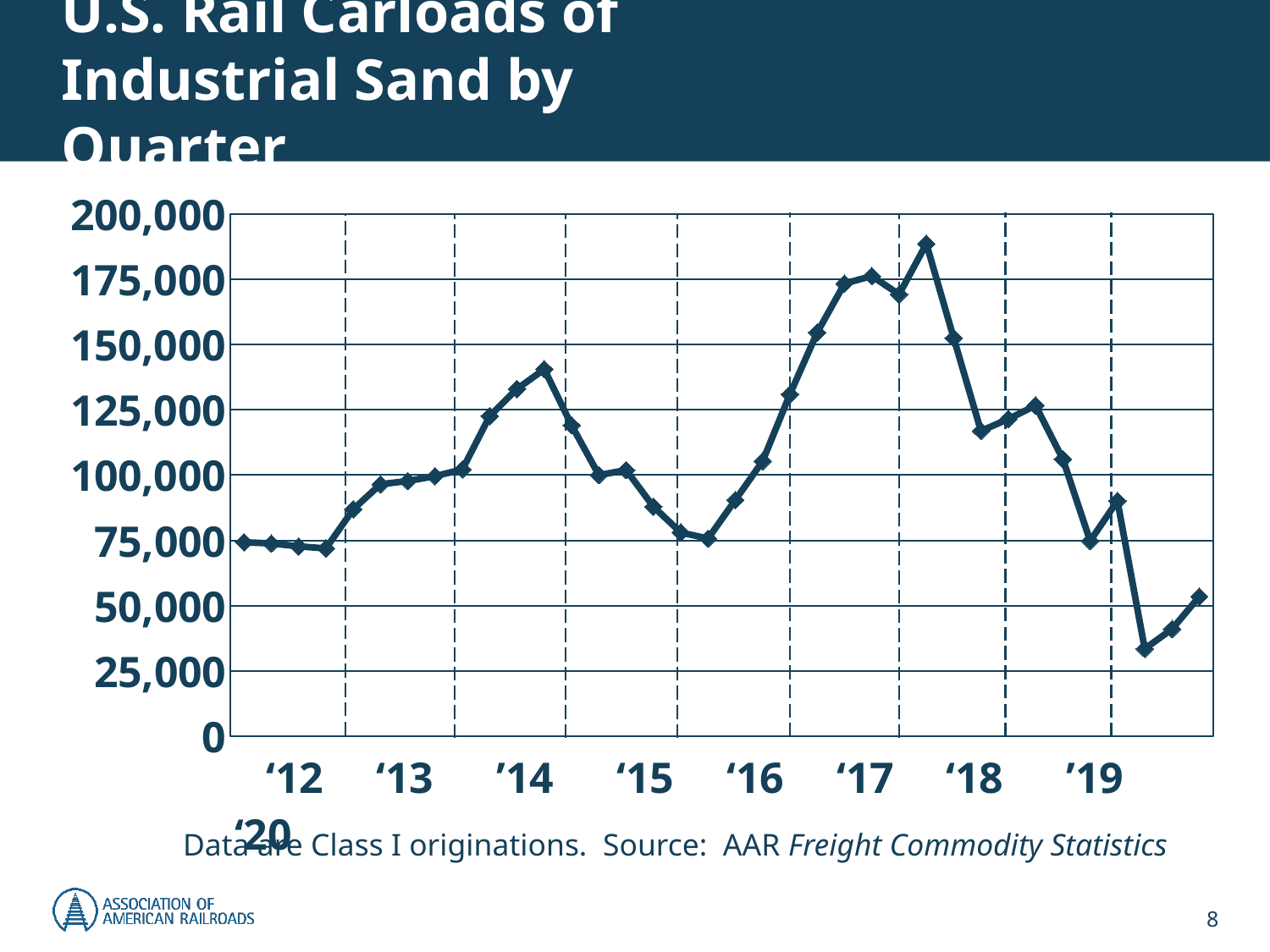
In which year does the line reach its highest point? '18 Is the highest value reached in '14 greater or less than 125,000? greater What kind of chart is shown on the slide? line chart Which is higher: the first value in '12 or the last value in '20? '12 Which is higher: the peak value in '14 or the peak value in '18? '18 Is the first plotted value in '12 greater or less than 100,000? less What is the title of the chart? U.S. Rail Carloads of Industrial Sand by Quarter How many year labels are shown on the x axis? 9 Is the highest value on the chart greater or less than 175,000? greater In which year does the line reach its lowest point? '20 Do the values generally rise or fall from the peak in '18 to the end of '20? fall